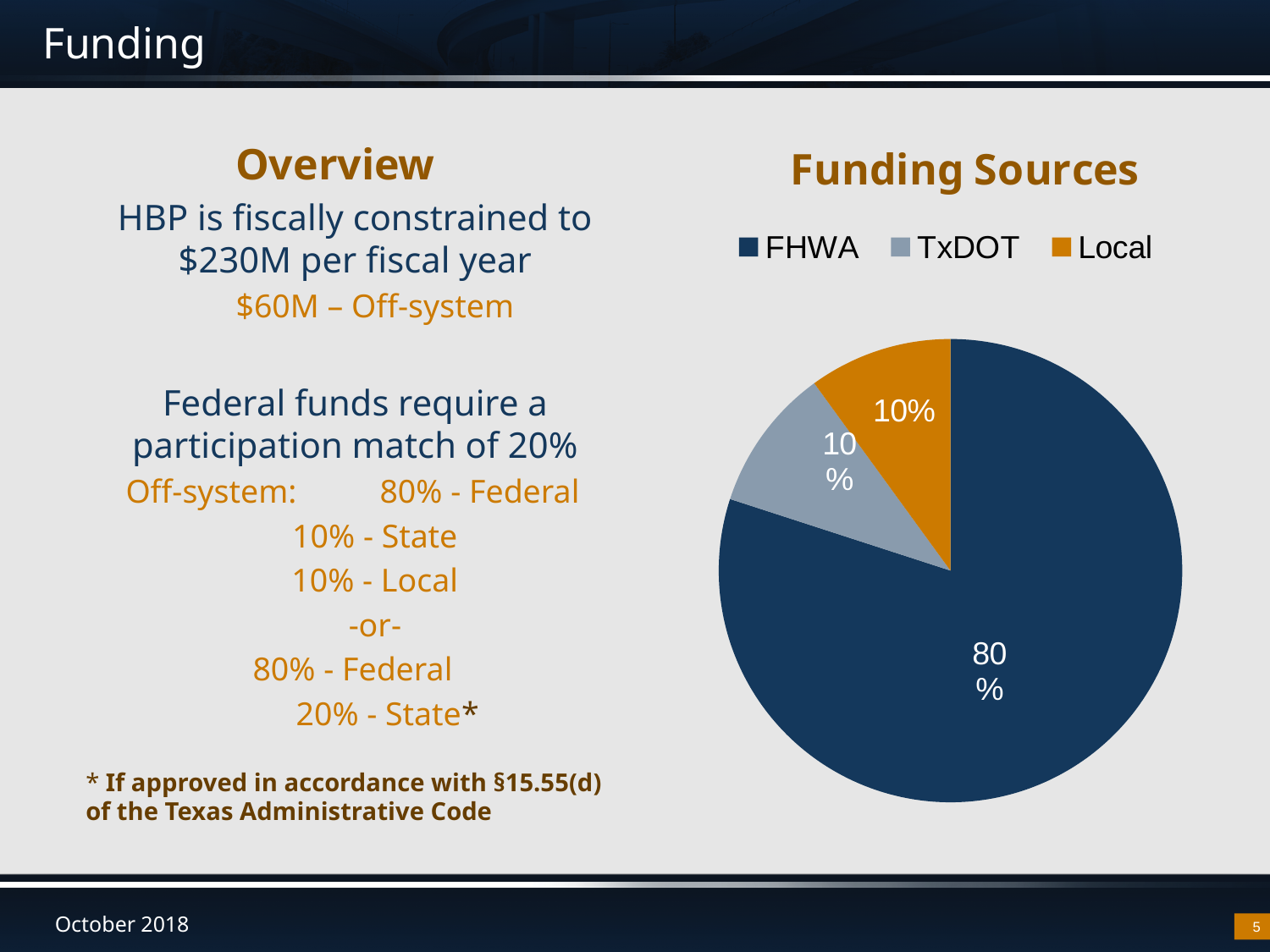
Is the FHWA share in the Funding Sources pie chart greater or less than 50%? greater What is the difference between the FHWA share and the Local share in the Funding Sources pie chart? 70% What is the title of the pie chart on the slide? Funding Sources What share of the Funding Sources pie does FHWA account for? 80% What share of the Funding Sources pie does Local account for? 10% How many entries does the legend of the Funding Sources chart list? 3 What kind of chart is shown under the title "Funding Sources"? pie chart Which colour represents Local in the Funding Sources pie chart? orange Which funding source has the largest slice in the Funding Sources pie chart? FHWA What share of the Funding Sources pie does TxDOT account for? 10% How many slices does the Funding Sources pie chart have? 3 Which is larger in the Funding Sources pie chart, the FHWA slice or the TxDOT slice? FHWA